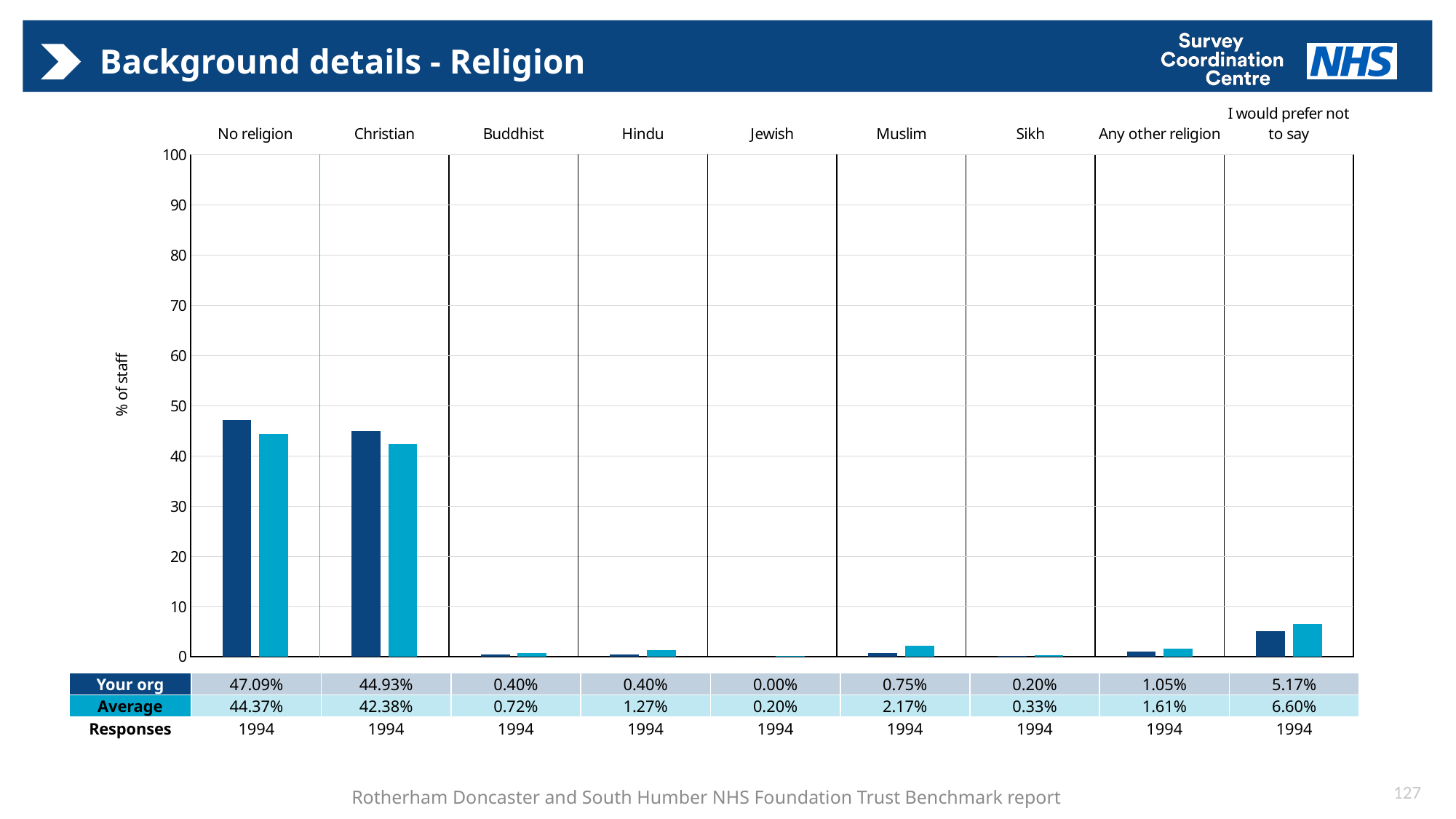
Is the 'Your org' value for Christian greater or less than 40? greater Which is larger for Hindu: the 'Your org' value or the Average value? Average What is the difference between the 'Your org' and Average values for No religion? 2.72% Which category has the lowest 'Your org' value? Jewish Which religion category has the highest 'Your org' value? No religion What is the Average value for Muslim? 2.17% What is the 'Your org' value for 'I would prefer not to say'? 5.17% What kind of chart is shown on the slide? Bar chart What is the 'Your org' value for No religion? 47.09% What is the Average value for Christian? 42.38% How many responses are recorded for each category? 1994 How many religion categories are shown on the chart? 9